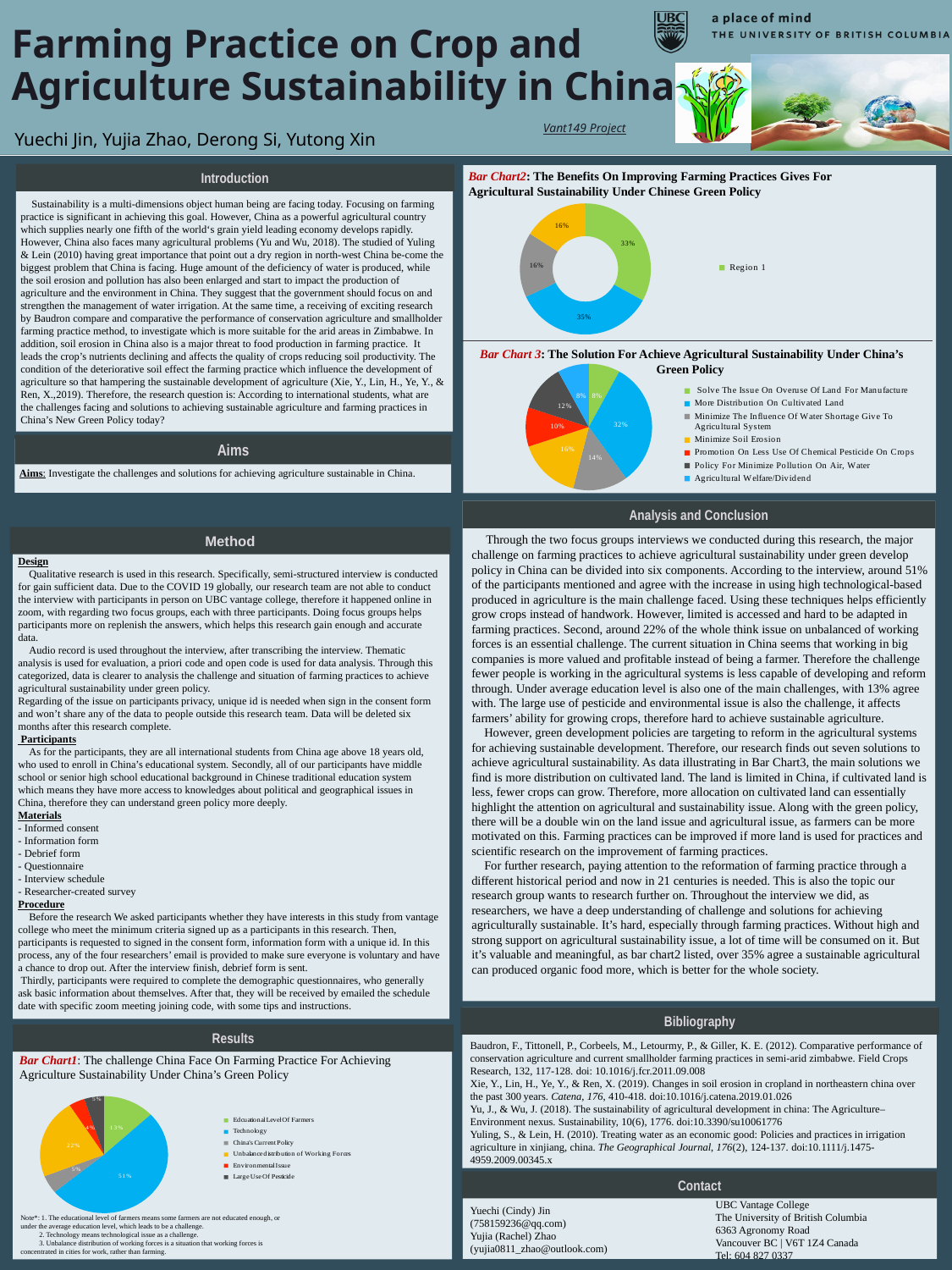
In Bar Chart2, what is the largest percentage shown on the chart? 35% In Bar Chart1, what is the difference between the Technology share and the Educational Level Of Farmers share? 38% In Bar Chart1, what percentage is shown for Unbalanced distribution of Working Forces? 22% In Bar Chart2, how many slices does the chart have? 4 In Bar Chart1, what share of participants named Technology as the challenge? 51% In Bar Chart1, how many challenge categories does the legend list? 6 What kind of chart is Bar Chart1? Pie chart In Bar Chart2, what is the only entry listed in the legend? Region 1 In Bar Chart 3, what percentage is shown for More Distribution On Cultivated Land? 32% In Bar Chart 3, which solution has the largest share? More Distribution On Cultivated Land In Bar Chart 3, which is larger: Minimize Soil Erosion or Promotion On Less Use Of Chemical Pesticide On Crops? Minimize Soil Erosion In Bar Chart1, which challenge has the largest share? Technology